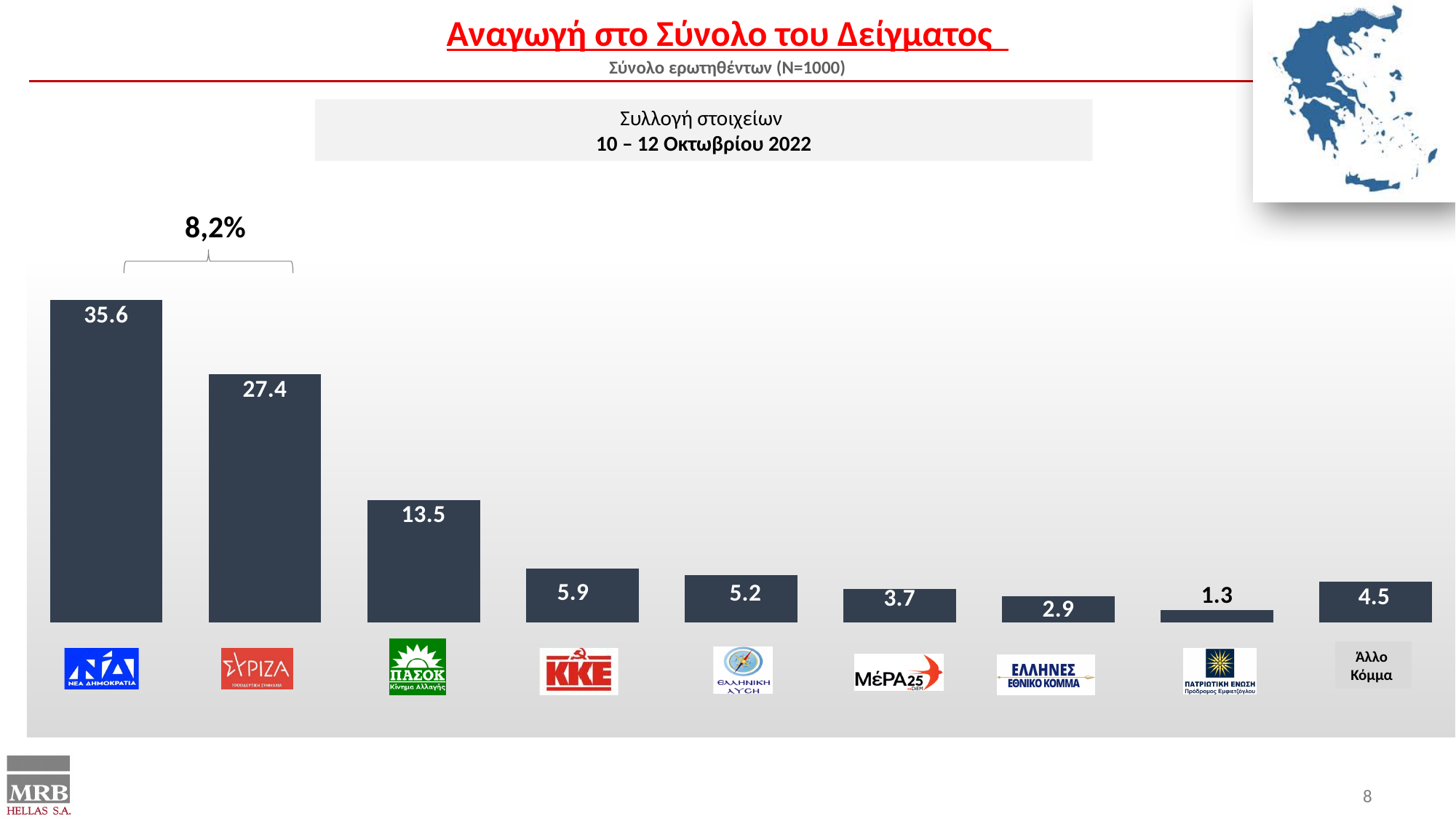
What is the value shown for ΚΚΕ? 5.9 What is the value shown for ΠΑΣΟΚ? 13.5 What is the value shown for Άλλο Κόμμα? 4.5 What is the difference between the values for ΠΑΣΟΚ and ΚΚΕ? 7.6 What is the value shown for ΝΕΑ ΔΗΜΟΚΡΑΤΙΑ? 35.6 How many bars are shown in the chart? 9 Which party has the highest value in the chart? ΝΕΑ ΔΗΜΟΚΡΑΤΙΑ Which has a larger value, ΜέΡΑ25 or ΕΛΛΗΝΙΚΗ ΛΥΣΗ? ΕΛΛΗΝΙΚΗ ΛΥΣΗ What kind of chart is shown on the slide? Bar chart What is the value shown for ΣΥΡΙΖΑ? 27.4 What is the difference between the values for ΝΕΑ ΔΗΜΟΚΡΑΤΙΑ and ΣΥΡΙΖΑ? 8.2 Which category has the lowest value in the chart? ΠΑΤΡΙΩΤΙΚΗ ΕΝΩΣΗ